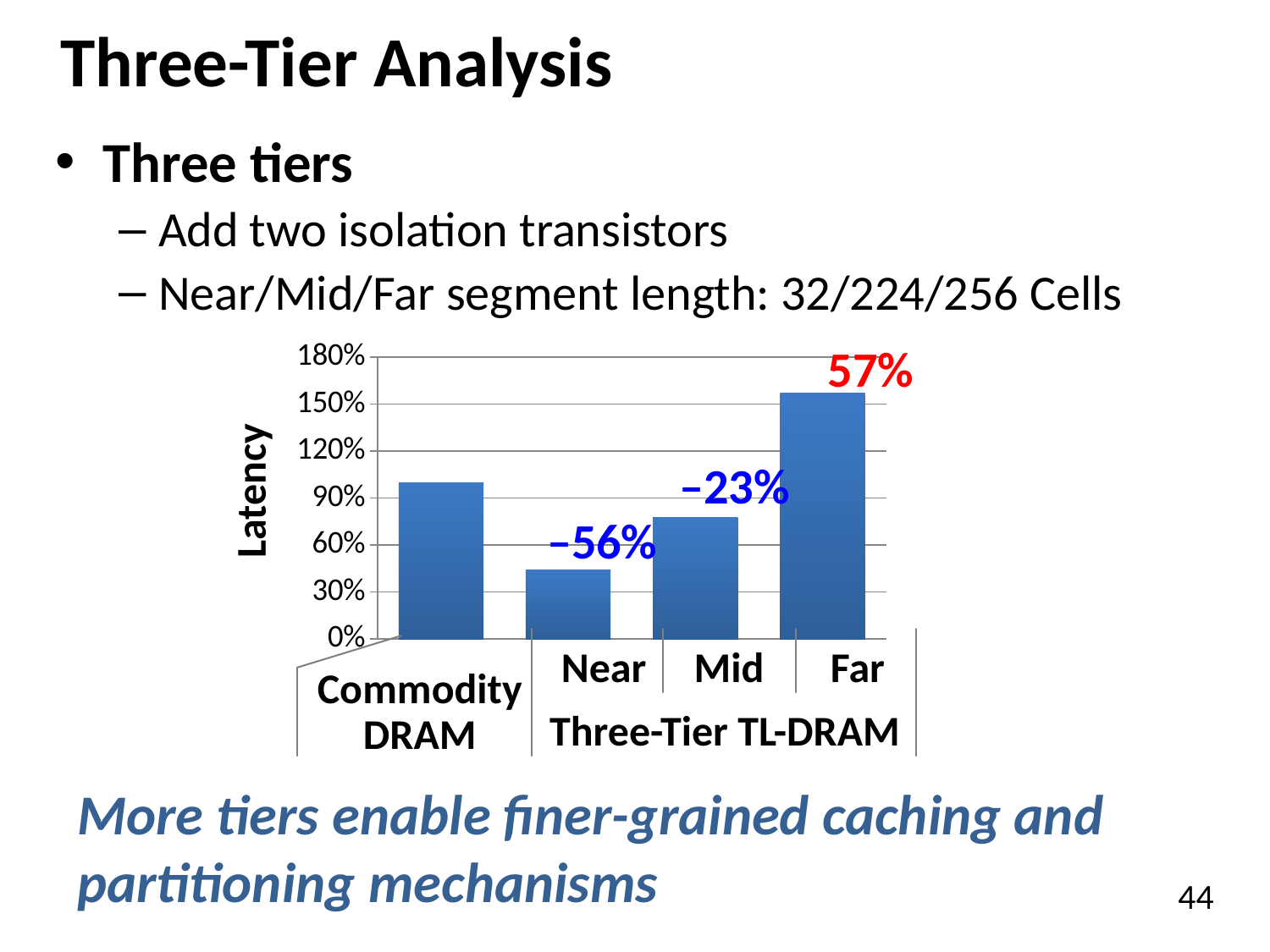
What kind of chart is shown on the slide? bar chart Which bar has the lowest latency? Near Is the latency for Near greater or less than 60%? less How many bars are plotted in the chart? 4 Which has higher latency, Mid or Near? Mid Is the latency for Mid greater or less than 90%? less Which bar has the highest latency? Far What is the label on the vertical axis of the chart? Latency Is the latency for Commodity DRAM greater or less than 90%? greater Which has higher latency, Commodity DRAM or Far? Far What percentage change is annotated above the Far bar? 57%